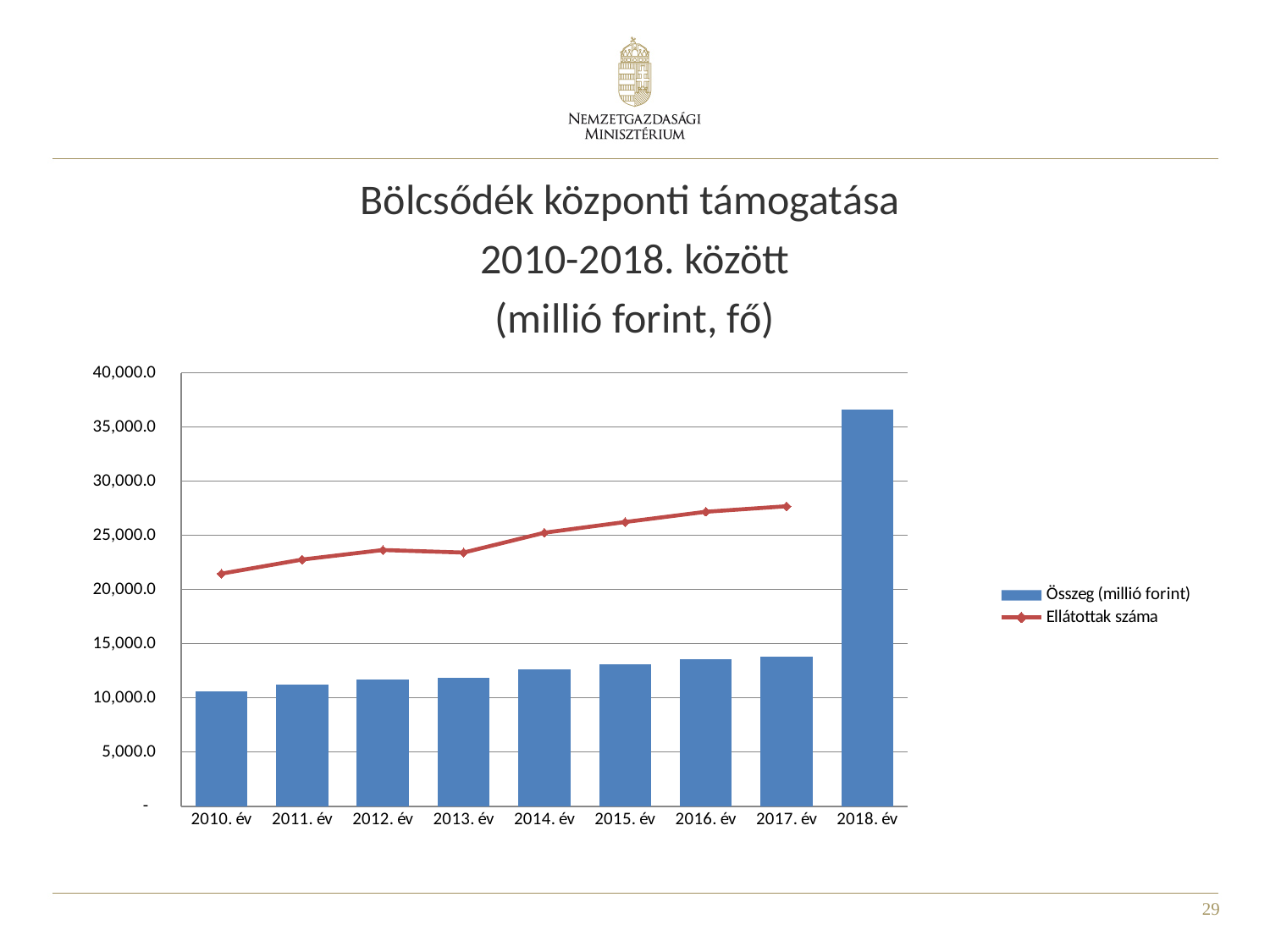
How many series does the legend list? 2 Which year has the lowest bar for Összeg (millió forint)? 2010. év What is the title of the chart? Bölcsődék központi támogatása 2010-2018. között (millió forint, fő) What kind of chart is shown on the slide? bar and line chart How many year categories are shown on the x axis? 9 Is the Összeg (millió forint) bar for 2018. év greater or less than 35,000.0? greater Is the Összeg (millió forint) bar for 2017. év greater or less than 15,000.0? less Do the Ellátottak száma values generally rise or fall from 2010. év to 2017. év? rise Is the Ellátottak száma value for 2017. év greater or less than 30,000.0? less Which is larger, the Összeg (millió forint) bar for 2018. év or for 2017. év? 2018. év Which year has the highest bar for Összeg (millió forint)? 2018. év